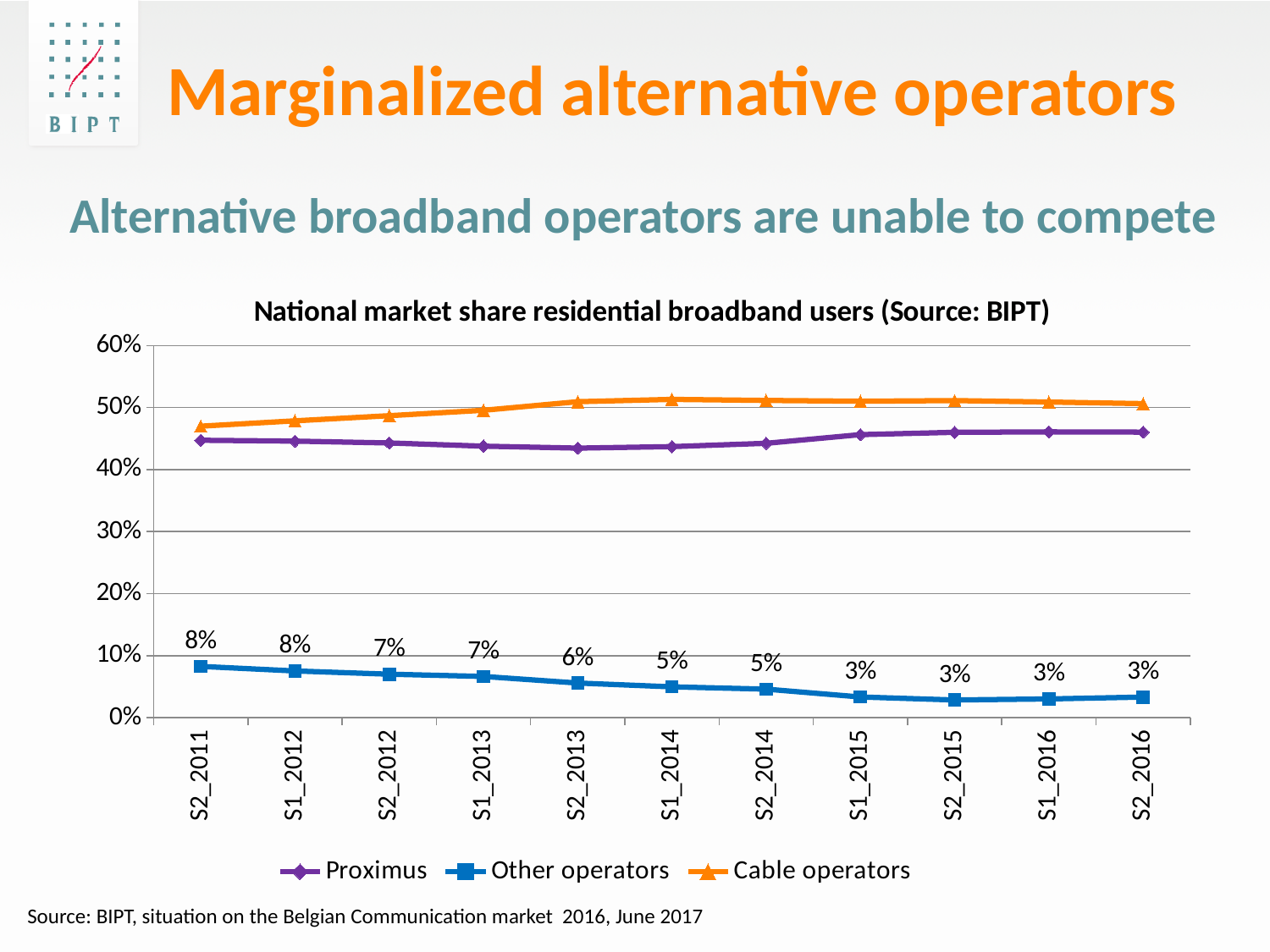
Does the Other operators share rise or fall from S2_2011 to S2_2016? Fall How many time periods are shown on the x axis? 11 Which series has the lowest market share across the whole period? Other operators Is the Proximus share in S2_2013 greater or less than 50%? less What is the market share of Other operators in S2_2016? 3% Is the Cable operators share in S2_2016 greater or less than 40%? greater How many series does the legend list? 3 Which series has the highest market share in S2_2016? Cable operators By how many percentage points did the Other operators share fall from S2_2011 to S2_2016? 5 percentage points What is the market share of Other operators in S2_2011? 8% What kind of chart is shown on the slide? Line chart What is the market share of Other operators in S2_2013? 6%